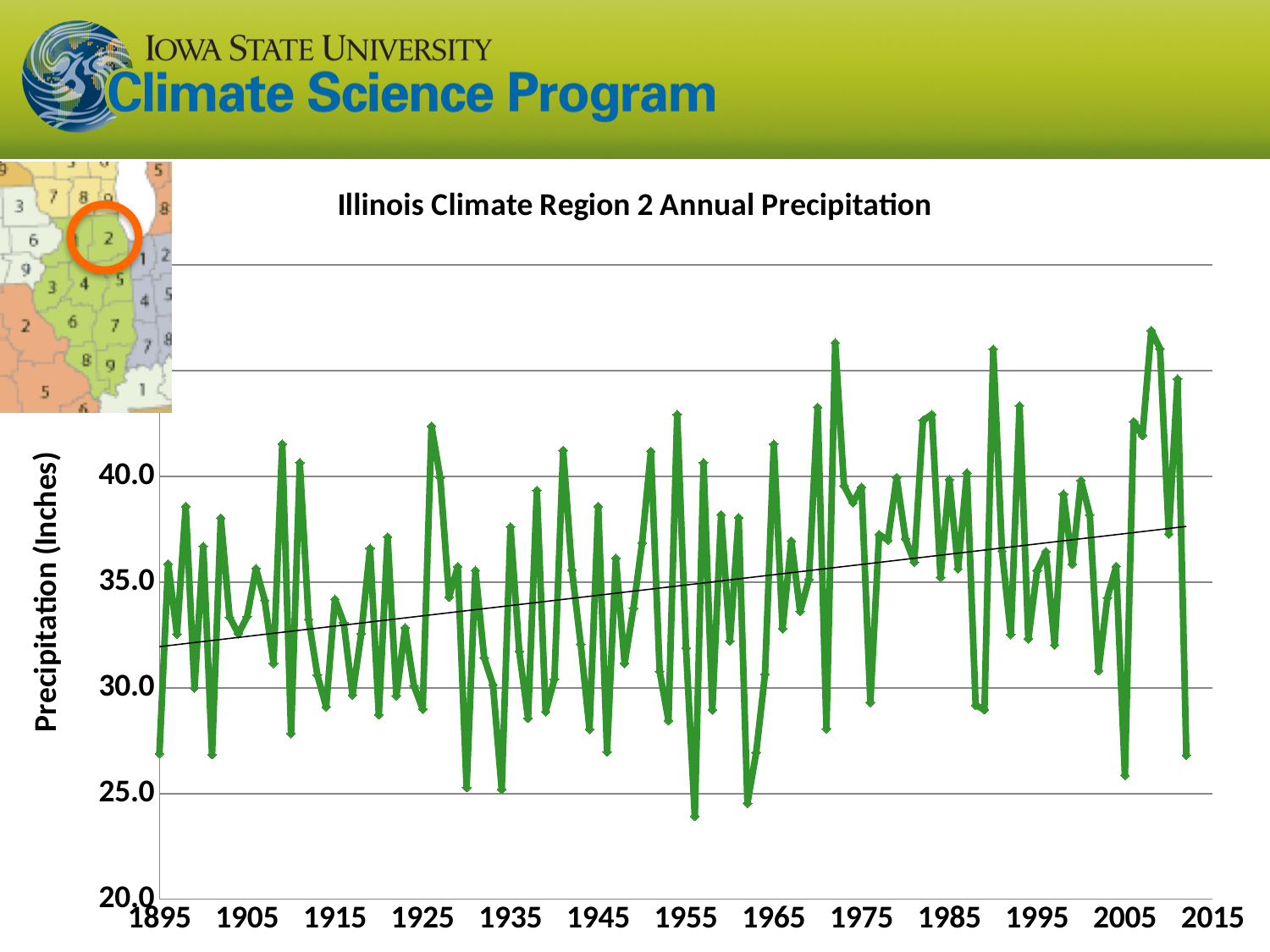
Is the precipitation value for 1895 greater or less than 30.0? less What kind of chart is shown on the slide? line chart Is the precipitation value for 1972 greater or less than 40.0? greater Is the precipitation value for 1956 greater or less than 25.0? less How many year labels are shown along the x axis? 13 What is the title of the chart? Illinois Climate Region 2 Annual Precipitation Which year has the highest annual precipitation on the chart? 2008 What is the label on the vertical axis of the chart? Precipitation (Inches) Does the trend line drawn through the precipitation data rise or fall from 1895 to 2015? rise